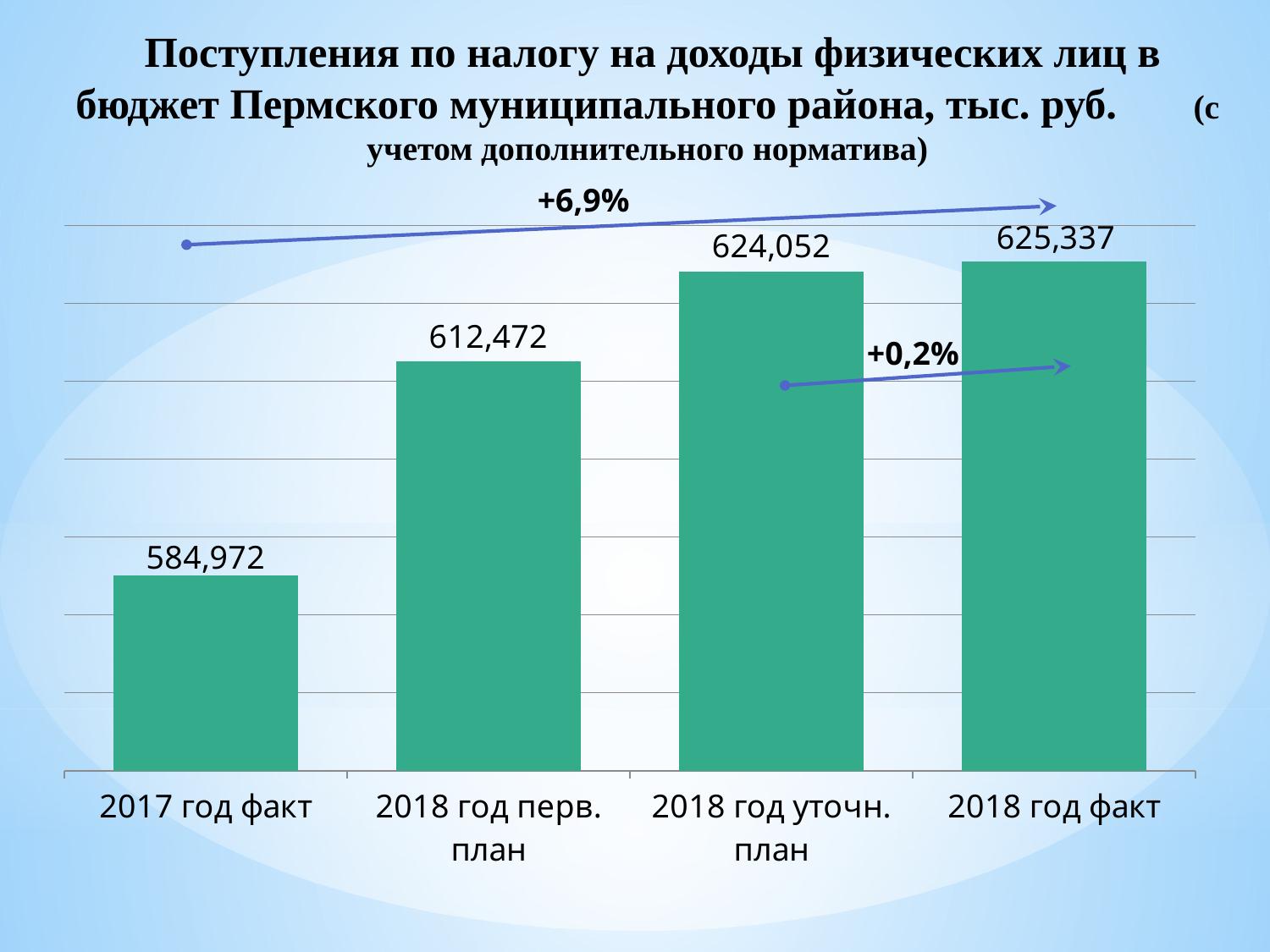
What is the value for 2018 год факт? 625,337 What is the value for 2017 год факт? 584,972 What is the difference between the values for 2018 год факт and 2017 год факт? 40,365 Which category has the lowest value? 2017 год факт Which category has the highest value? 2018 год факт What kind of chart is shown on the slide? bar chart How many categories are shown on the x axis? 4 Which is larger, the value for 2018 год перв. план or the value for 2017 год факт? 2018 год перв. план What is the difference between the values for 2018 год уточн. план and 2018 год перв. план? 11,580 What percentage change is annotated between 2017 год факт and 2018 год факт? +6,9% What is the value for 2018 год перв. план? 612,472 What is the value for 2018 год уточн. план? 624,052